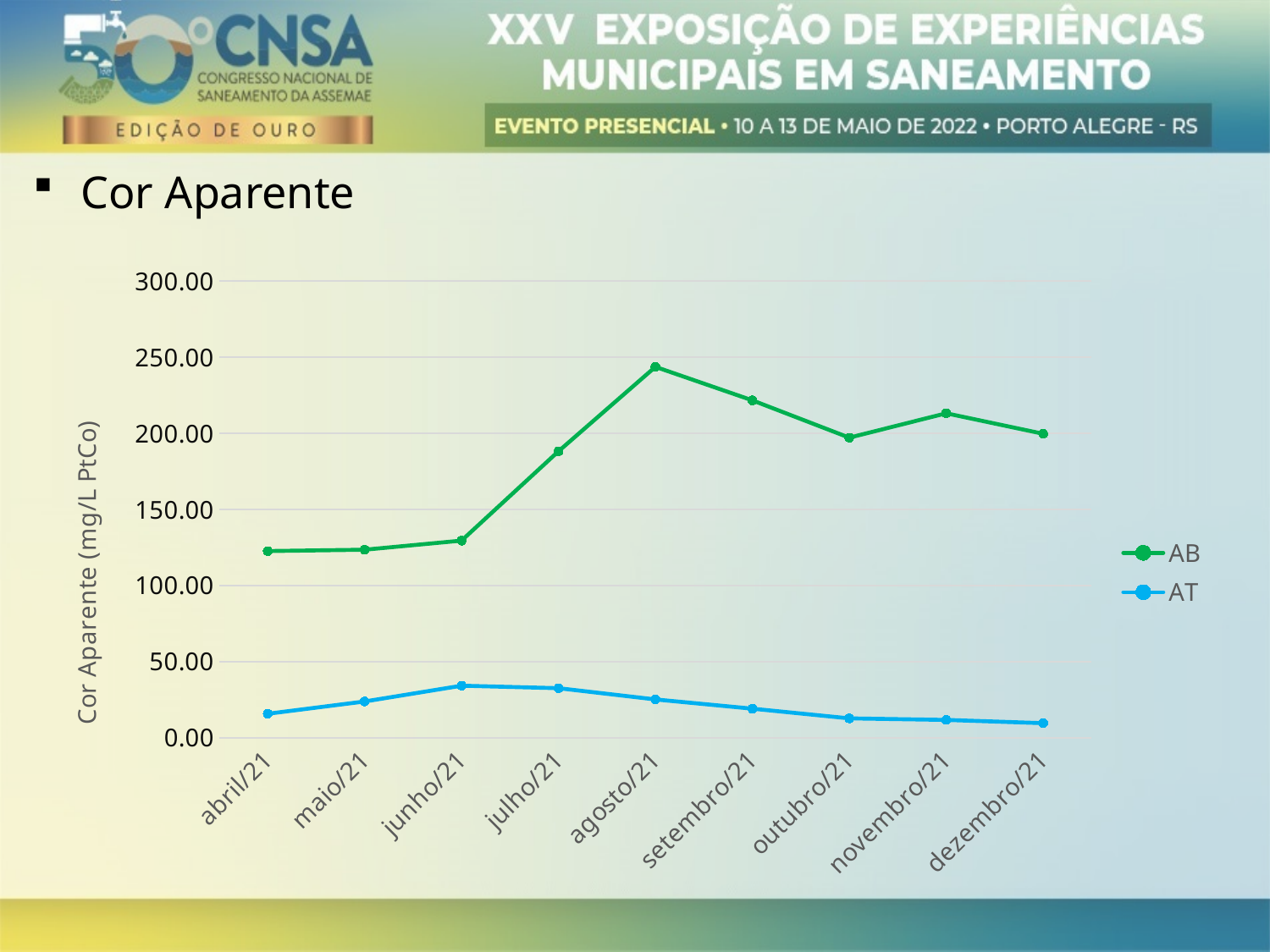
Which is larger, the AB value in agosto/21 or the AB value in outubro/21? agosto/21 Does the AB series rise or fall from abril/21 to agosto/21? rise In which month does the AB series reach its highest value? agosto/21 Which is larger, the AT value in junho/21 or the AT value in dezembro/21? junho/21 What kind of chart is shown on the slide? line chart Does the AT series rise or fall from junho/21 to dezembro/21? fall Is the value for AB in agosto/21 greater or less than 200.00? greater Is the value for AB in abril/21 greater or less than 150.00? less How many months are plotted along the x axis? 9 Is the value for AT in junho/21 greater or less than 50.00? less How many series does the legend list? 2 What is the label on the vertical axis of the chart? Cor Aparente (mg/L PtCo)